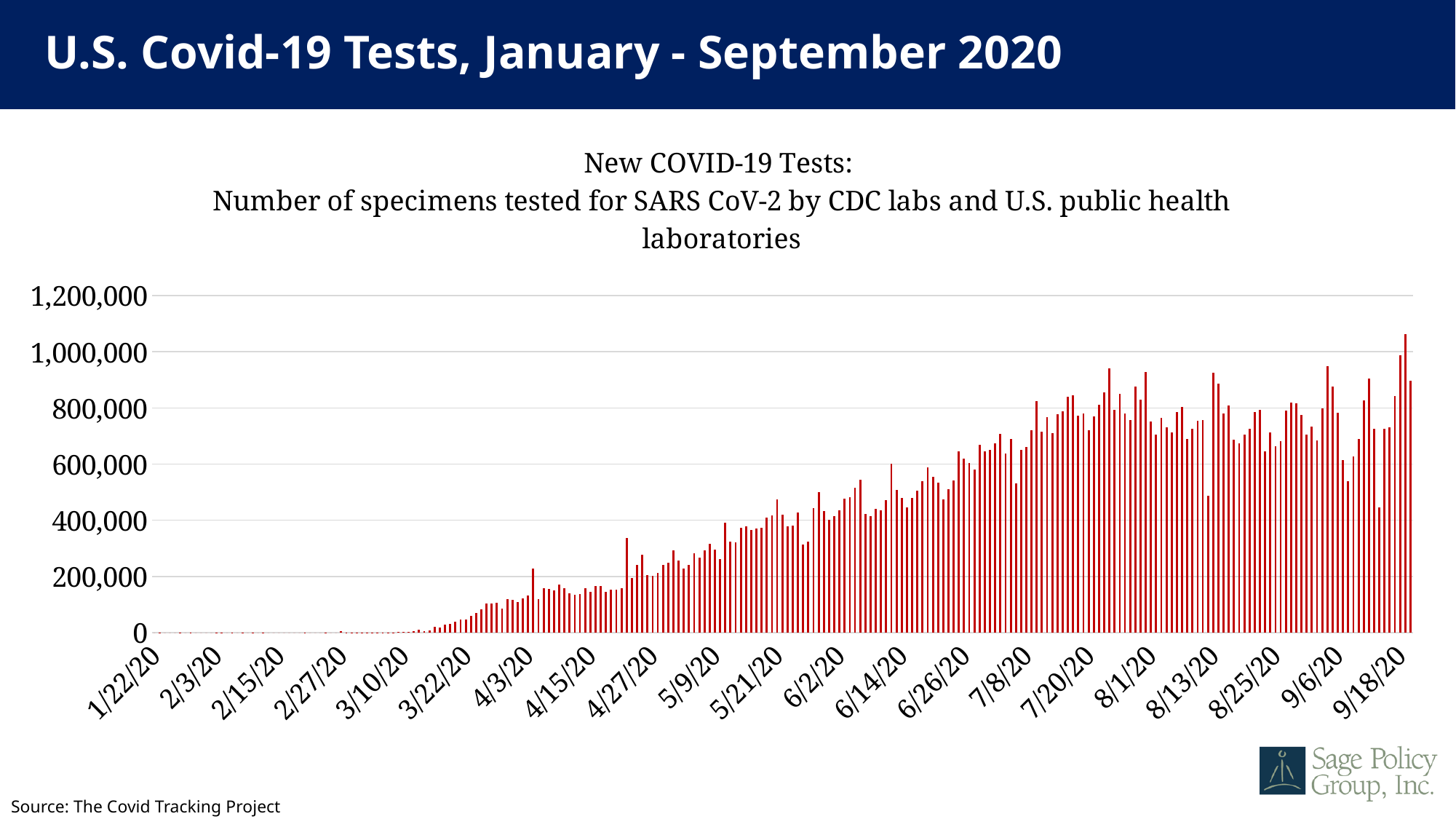
Is the value for 7/8/20 greater or less than 600,000? greater Is the value for 9/6/20 greater or less than 400,000? greater What is the highest value shown on the vertical axis? 1,200,000 Is the value for 3/10/20 greater or less than 200,000? less What source is cited for the chart? The Covid Tracking Project In which month does the tallest bar on the chart occur? September Do the values generally rise or fall from January to September 2020? Rise What kind of chart is shown on the slide? Bar chart